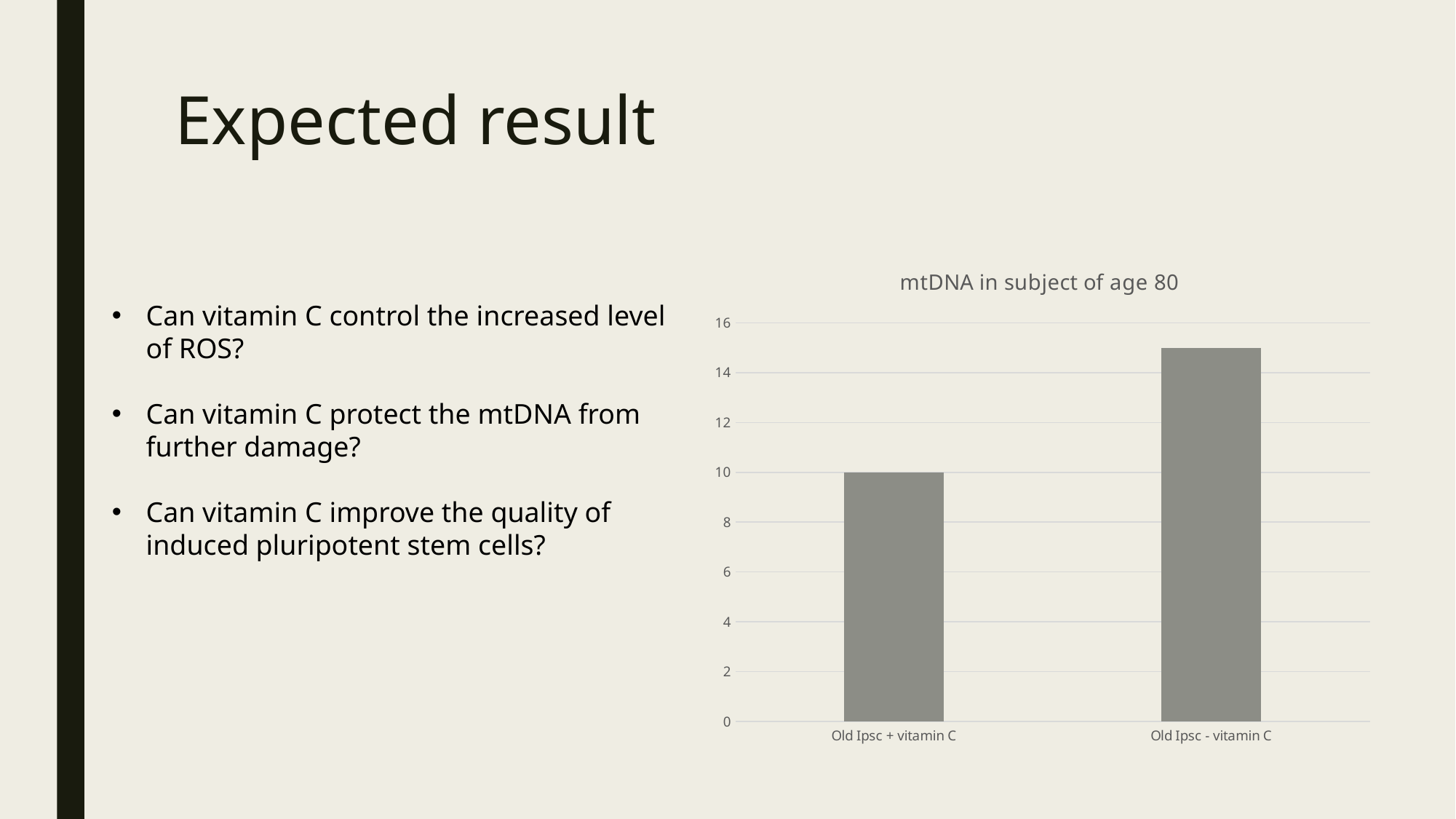
Which category has the lowest value? Old Ipsc + vitamin C How many categories are plotted in the chart? 2 Which is larger, the value for Old Ipsc + vitamin C or Old Ipsc - vitamin C? Old Ipsc - vitamin C Is the value for Old Ipsc + vitamin C greater or less than 12? less What is the title of the chart? mtDNA in subject of age 80 Which category has the highest value? Old Ipsc - vitamin C What is the value for Old Ipsc + vitamin C? 10 Is the value for Old Ipsc - vitamin C greater or less than 14? greater What kind of chart is shown on the slide? bar chart What is the highest value shown on the vertical axis? 16 Is the value for Old Ipsc - vitamin C greater or less than 16? less